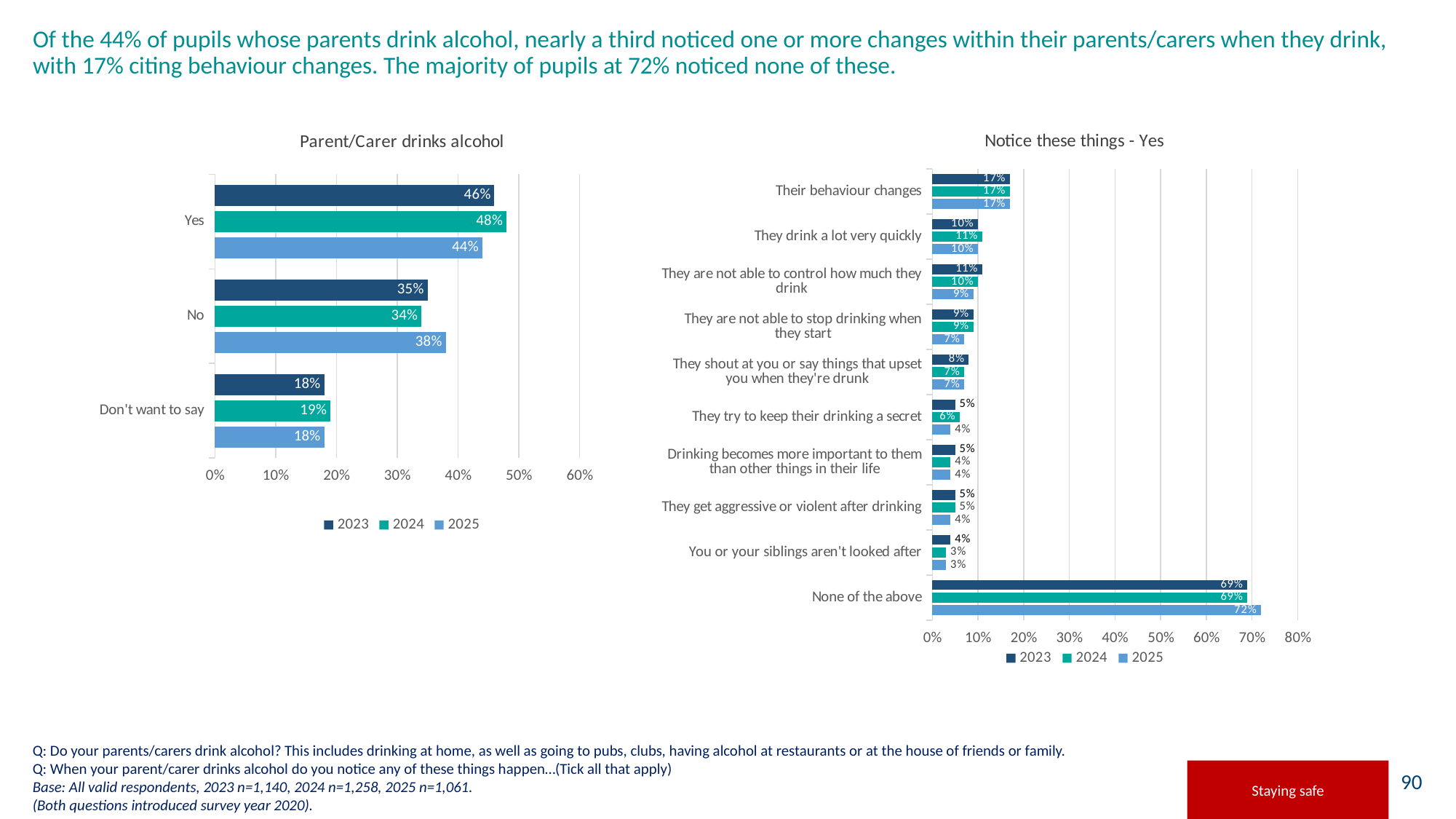
In the 'Notice these things - Yes' chart, which category has the highest values? None of the above In the 'Parent/Carer drinks alcohol' chart, how many series does the legend list? 3 In the 'Parent/Carer drinks alcohol' chart, which year has the highest value for 'Yes'? 2024 In the 'Notice these things - Yes' chart, what is the value for 'They drink a lot very quickly' in 2024? 11% In the 'Notice these things - Yes' chart, how many categories are shown? 10 In the 'Notice these things - Yes' chart, what is the difference between the 2023 and 2025 values for 'They are not able to stop drinking when they start'? 2% In the 'Parent/Carer drinks alcohol' chart, what is the difference between the 2025 and 2024 values for 'No'? 4% In the 'Notice these things - Yes' chart, is the 2023 value for 'Their behaviour changes' larger or smaller than the 2023 value for 'They drink a lot very quickly'? Larger In the 'Parent/Carer drinks alcohol' chart, what is the value for 'Yes' in 2025? 44% What kind of chart is the 'Notice these things - Yes' chart? Bar chart In the 'Parent/Carer drinks alcohol' chart, what is the value for 'No' in 2024? 34% In the 'Notice these things - Yes' chart, what is the value for 'None of the above' in 2025? 72%